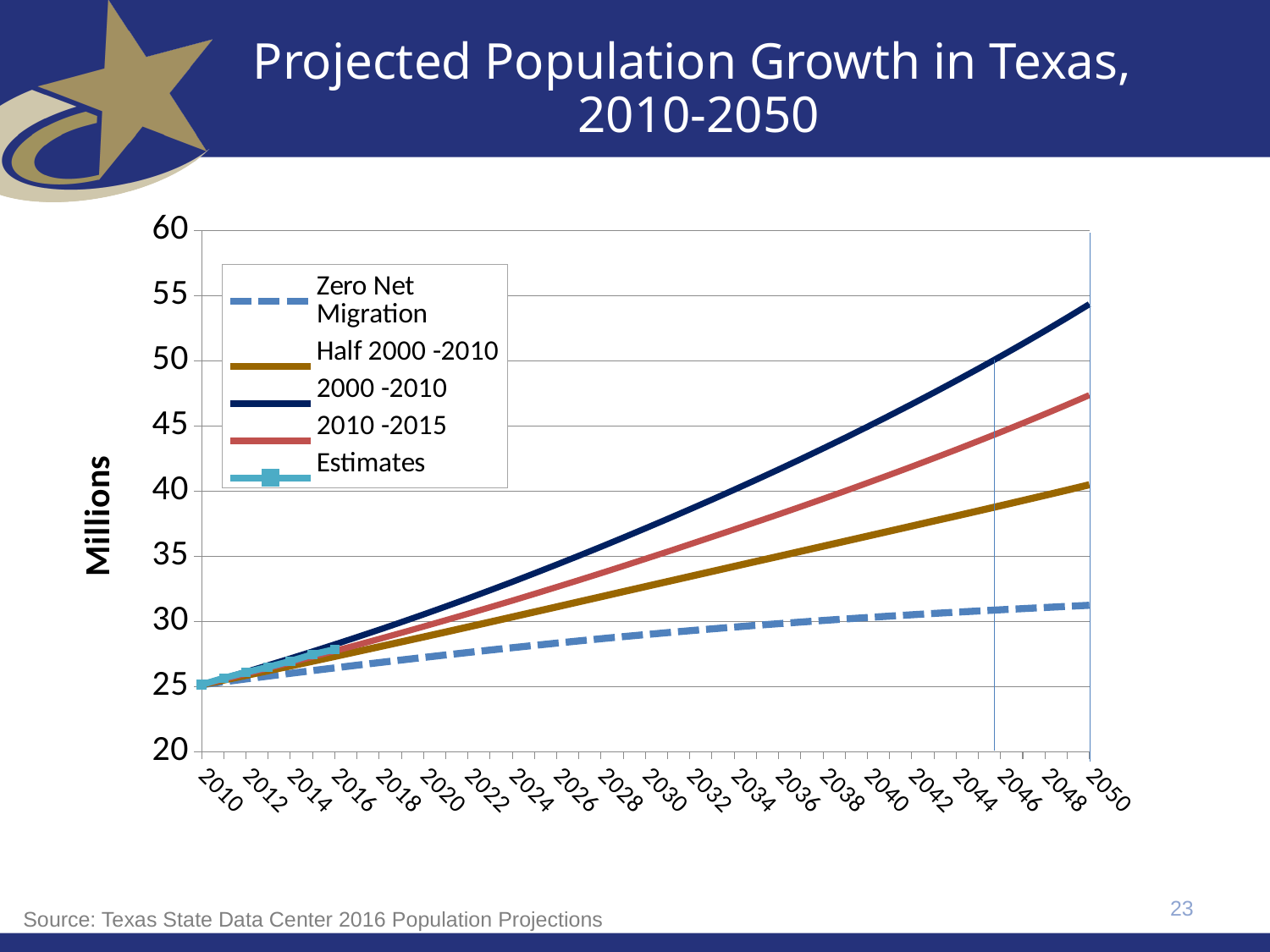
In 2050, which series is higher: 2010 -2015 or Half 2000 -2010? 2010 -2015 Which series has the lowest value in 2050? Zero Net Migration What is the title of the chart? Projected Population Growth in Texas, 2010-2050 Which series reaches the highest value in 2050? 2000 -2010 How many series does the legend list? 5 Does the 2000 -2010 series rise or fall from 2010 to 2050? rise What is the label on the vertical axis? Millions Is the value of the 2000 -2010 series in 2050 greater or less than 50? greater Is the value of the Half 2000 -2010 series in 2050 greater or less than 45? less Is the value of the 2010 -2015 series in 2050 greater or less than 45? greater What kind of chart is shown on the slide? line chart